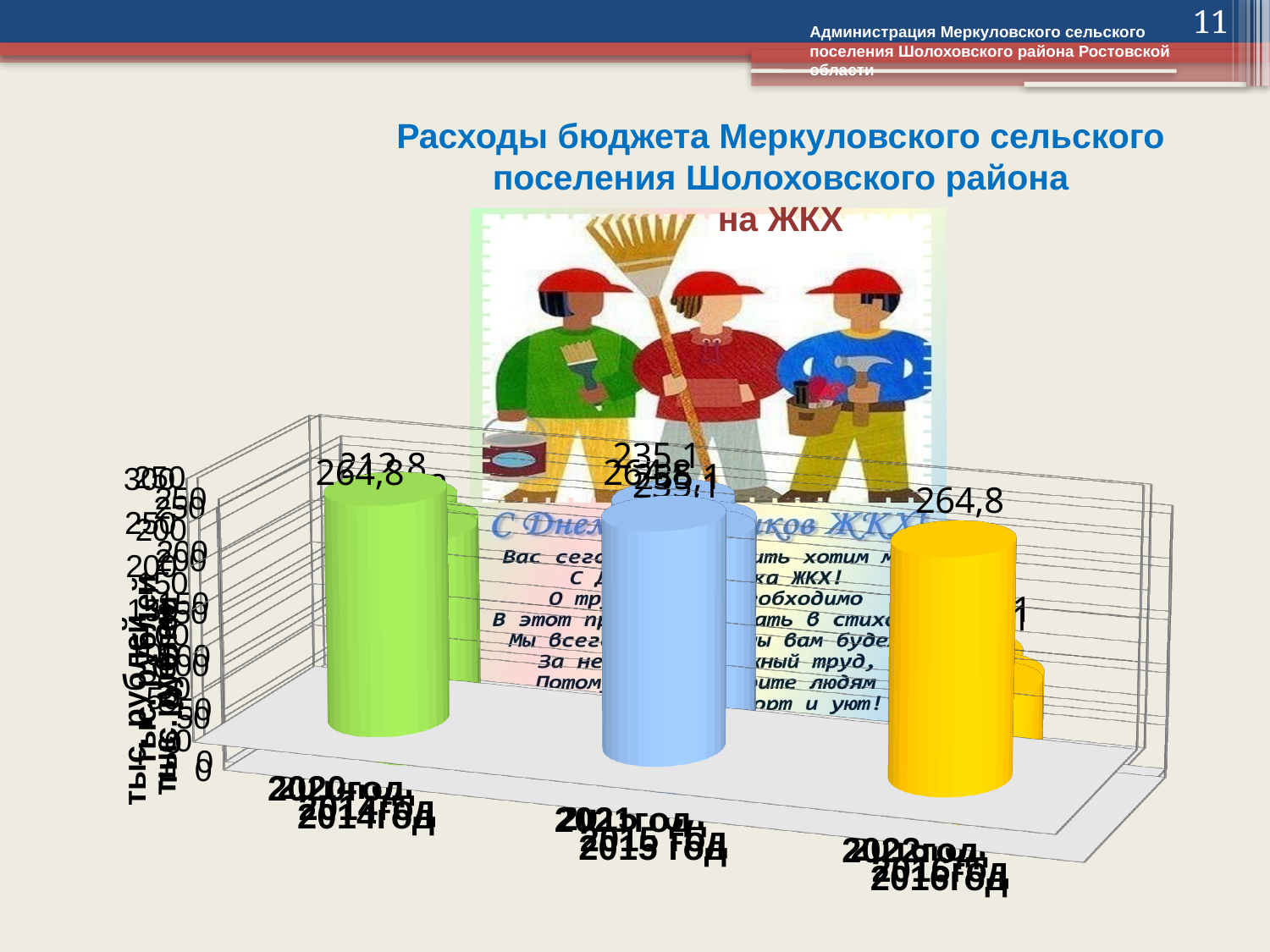
How many bars are in the front chart on the slide? 3 What value is printed above the yellow bar in the front chart? 264,8 What colours are the three bars in the front chart, from left to right? green, blue, yellow What is the title of the chart on the slide? Расходы бюджета Меркуловского сельского поселения Шолоховского района на ЖКХ What kind of chart is shown on the slide? bar chart